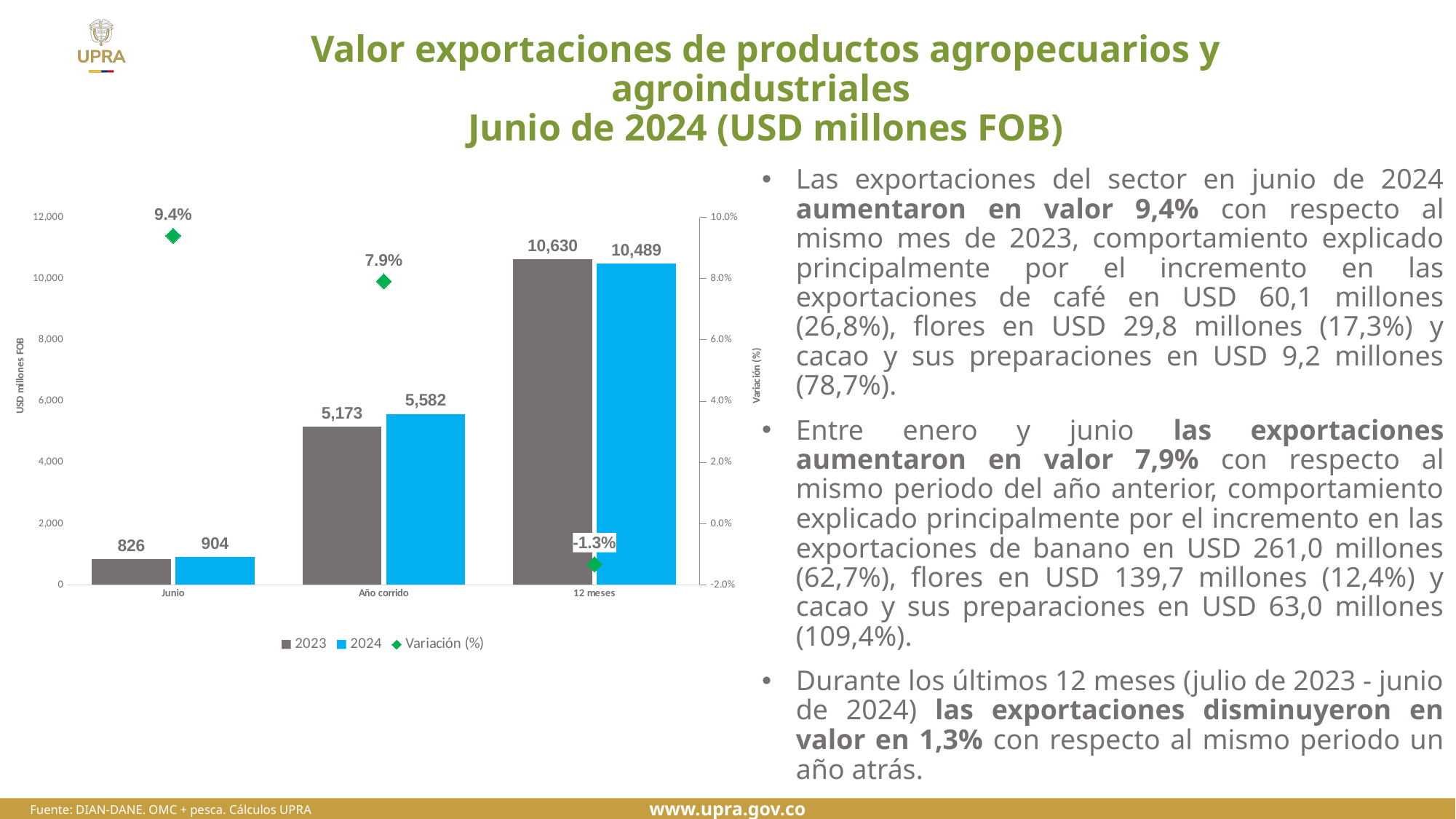
What is the 2024 value for Junio? 904 How many categories are shown on the x axis? 3 Which category has the lowest 2023 value? Junio What kind of chart is used for the 2023 and 2024 series? Bar chart What is the Variación (%) value for 12 meses? -1.3% Which category has the highest Variación (%) value? Junio How many series does the legend list? 3 Which is larger for Año corrido, the 2023 value or the 2024 value? 2024 Which category has the highest 2024 value? 12 meses What is the 2023 value for Año corrido? 5,173 What is the difference between the 2023 and 2024 values for 12 meses? 141 What is the label of the left vertical axis? USD millones FOB